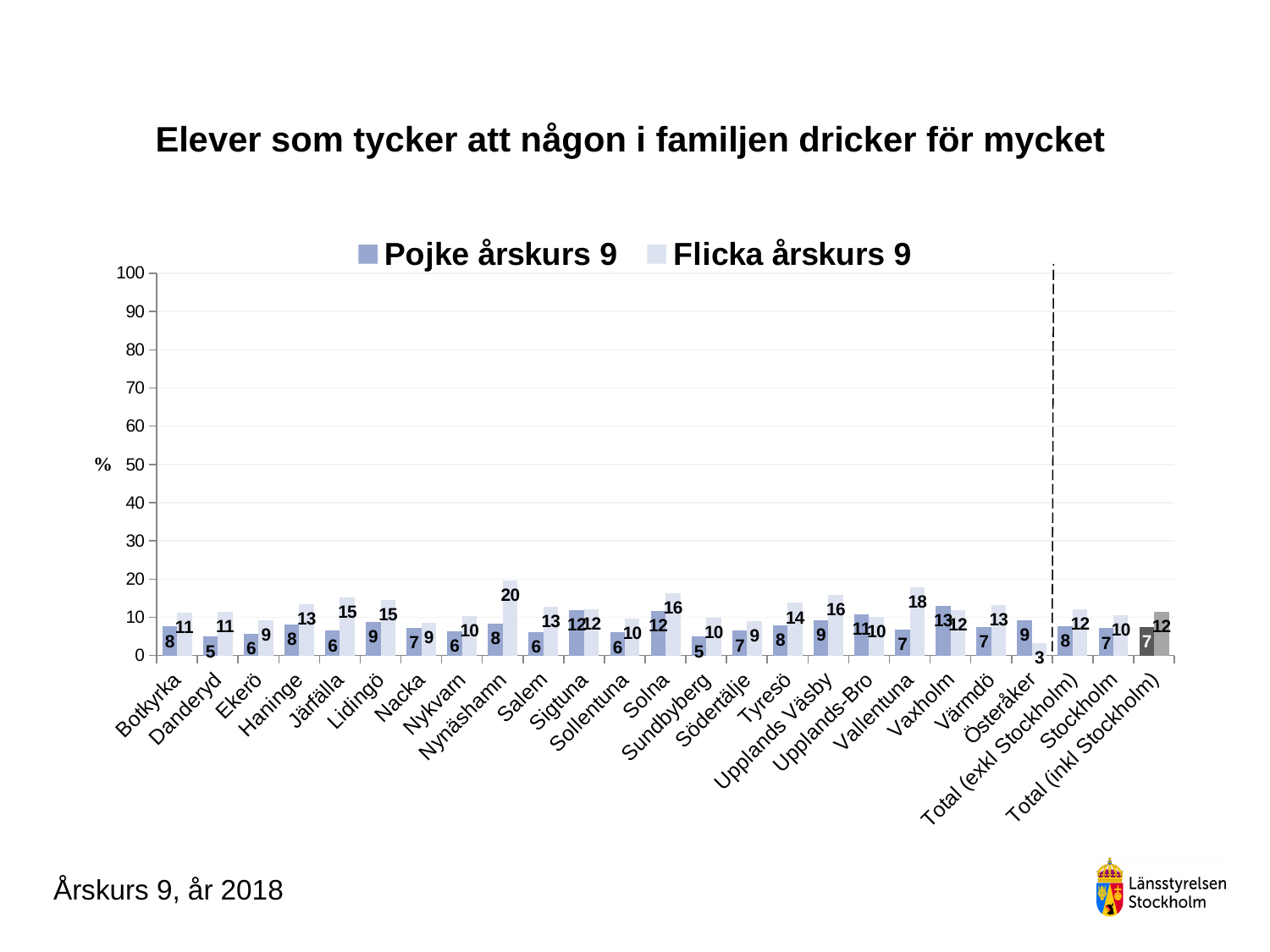
Which category has the highest value for Pojke årskurs 9? Vaxholm What is the value for Pojke årskurs 9 in Vaxholm? 13 Which category has the highest value for Flicka årskurs 9? Nynäshamn Which category has the lowest value for Flicka årskurs 9? Österåker What kind of chart is shown on the slide? Bar chart How many series does the legend list? 2 How many categories are shown on the x axis? 25 What is the value for Flicka årskurs 9 in Österåker? 3 What is the difference between the Flicka årskurs 9 and Pojke årskurs 9 values in Vallentuna? 11 Which is larger in Upplands-Bro: the Pojke årskurs 9 value or the Flicka årskurs 9 value? Pojke årskurs 9 What is the value for Flicka årskurs 9 in Nynäshamn? 20 What is the title of the chart? Elever som tycker att någon i familjen dricker för mycket